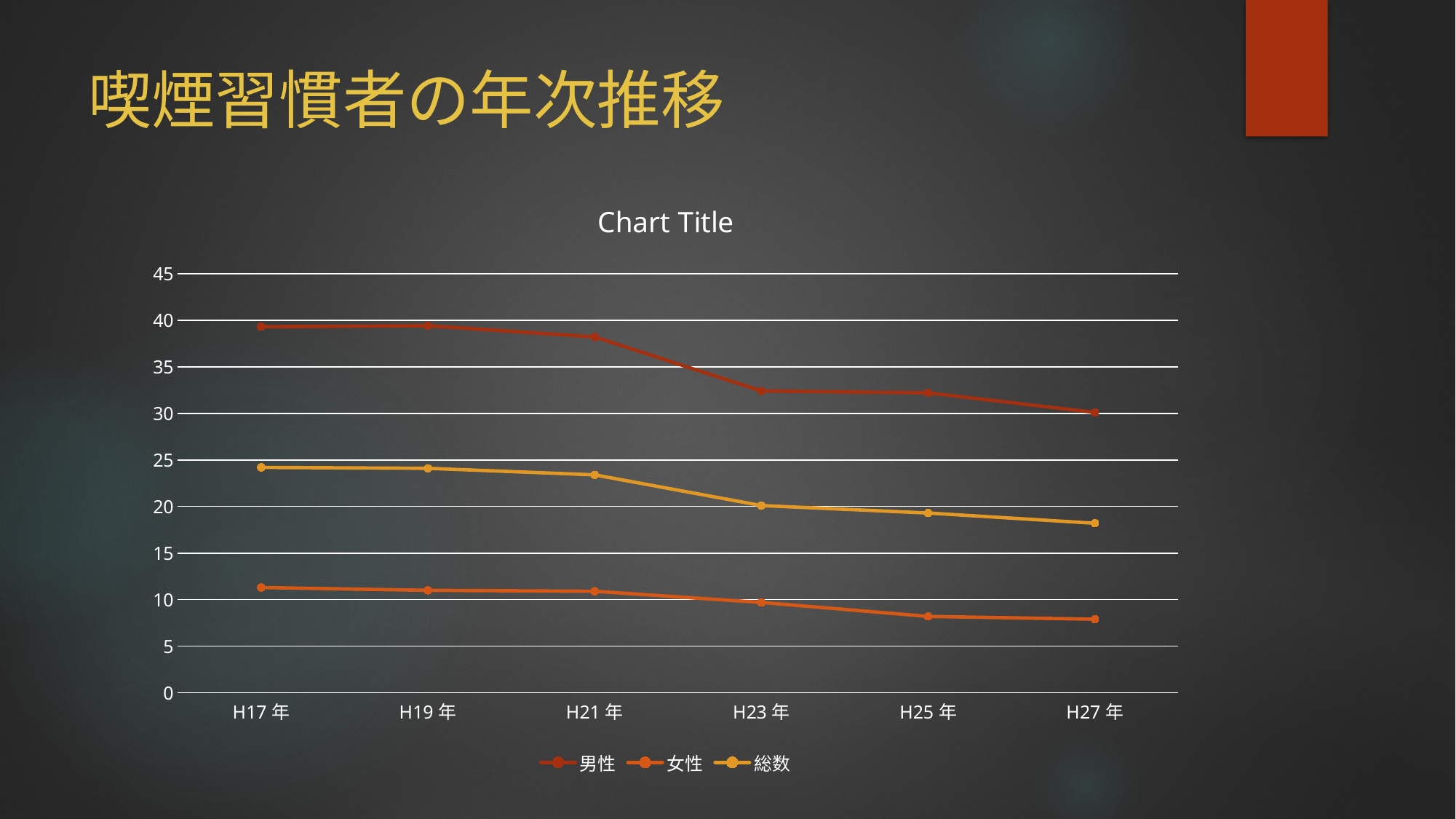
Is the value for 男性 at H21 年 greater or less than 40? less Which is larger at H25 年, the value for 男性 or the value for 女性? 男性 How many points are plotted along the x axis for each series? 6 Does the 男性 series rise or fall from H17 年 to H27 年? fall Does the 総数 series rise or fall across the years shown? fall Is the value for 女性 at H27 年 greater or less than 10? less What is the title shown above the chart? Chart Title What kind of chart is shown on the slide? line chart In which year is the 男性 series at its lowest? H27 年 Is the value for 男性 at H23 年 greater or less than 30? greater How many series does the legend list? 3